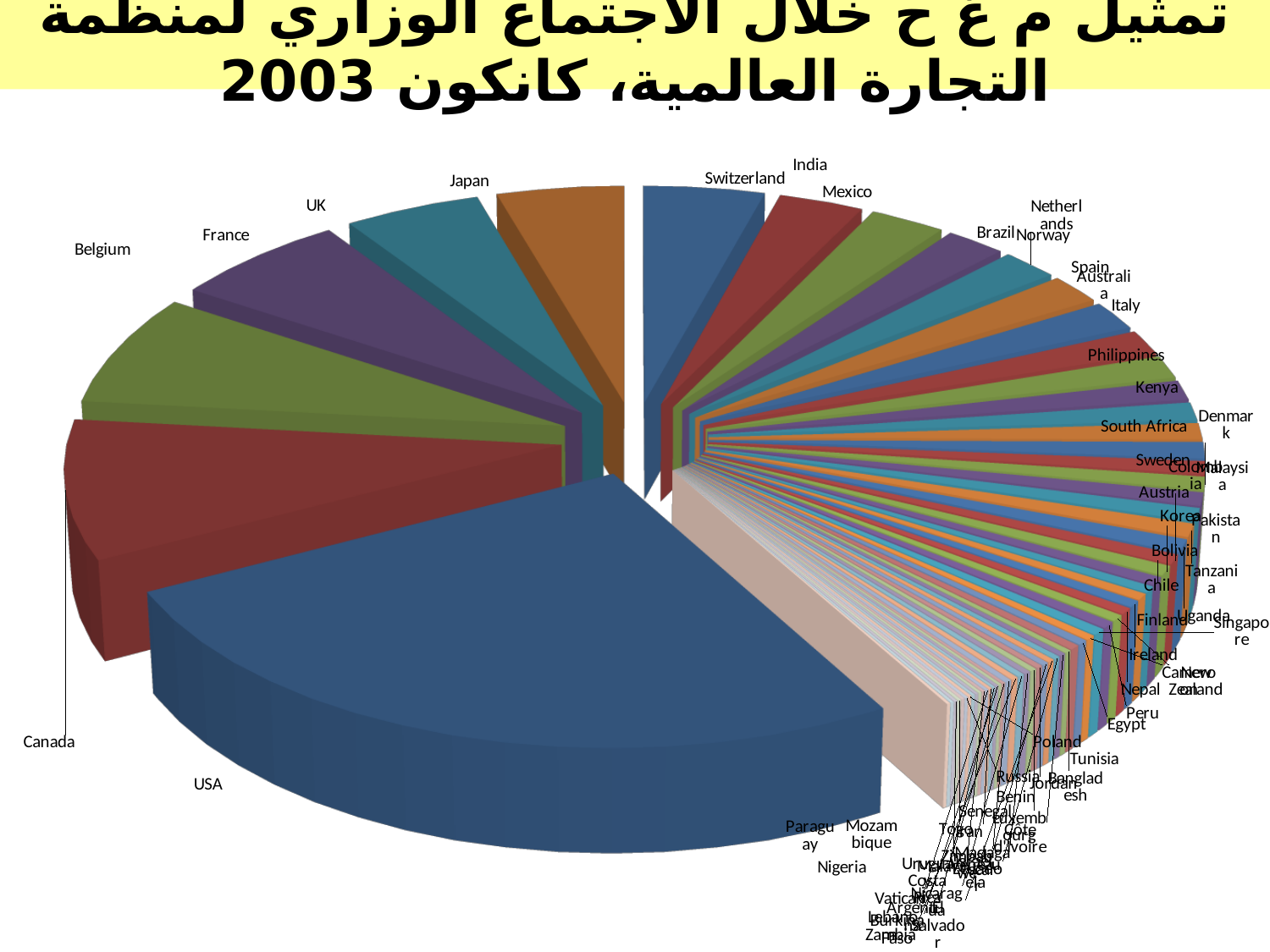
What kind of chart is shown on the slide? pie chart Which slice is larger, Belgium or Switzerland? Belgium Which slice is larger, Canada or Mexico? Canada Which year is mentioned in the slide title? 2003 Which city is mentioned in the slide title? كانكون (Cancun) Which slice is larger, USA or Canada? USA Which country has the largest slice of the pie? USA